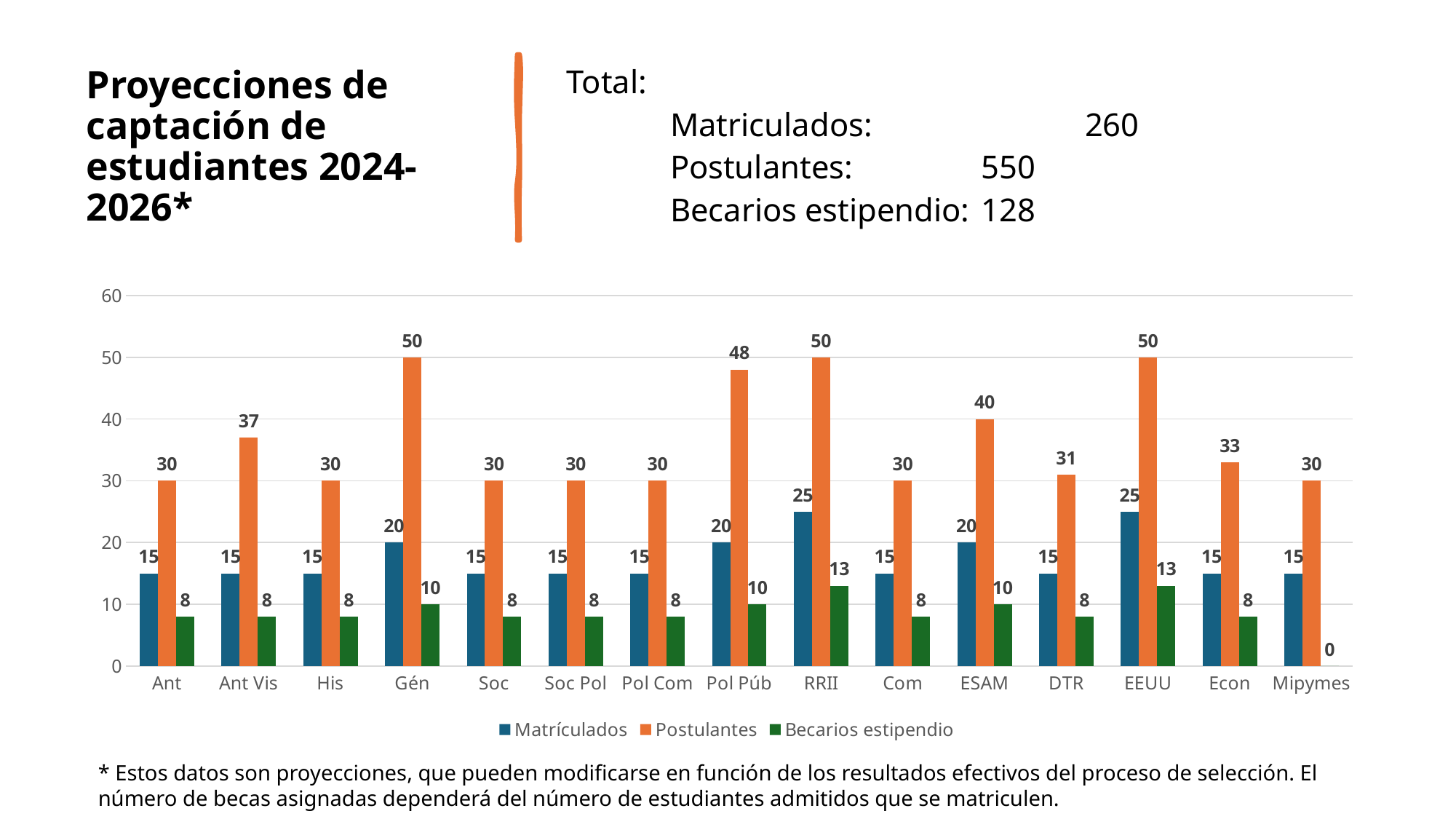
What is the Postulantes value for Pol Púb? 48 Which series is shown in orange in the legend? Postulantes What is the difference between the Postulantes values for Gén and ESAM? 10 Which category has the highest Postulantes value among Ant Vis, DTR and Econ? Ant Vis What is the Becarios estipendio value for Mipymes? 0 What is the Matrículados value for RRII? 25 What kind of chart is shown on the slide? Bar chart How many series does the legend list? 3 How many categories are shown on the x axis? 15 What is the Postulantes value for Ant Vis? 37 Which category has the lowest Becarios estipendio value? Mipymes Which is larger: the Matrículados value for EEUU or the Matrículados value for Econ? EEUU